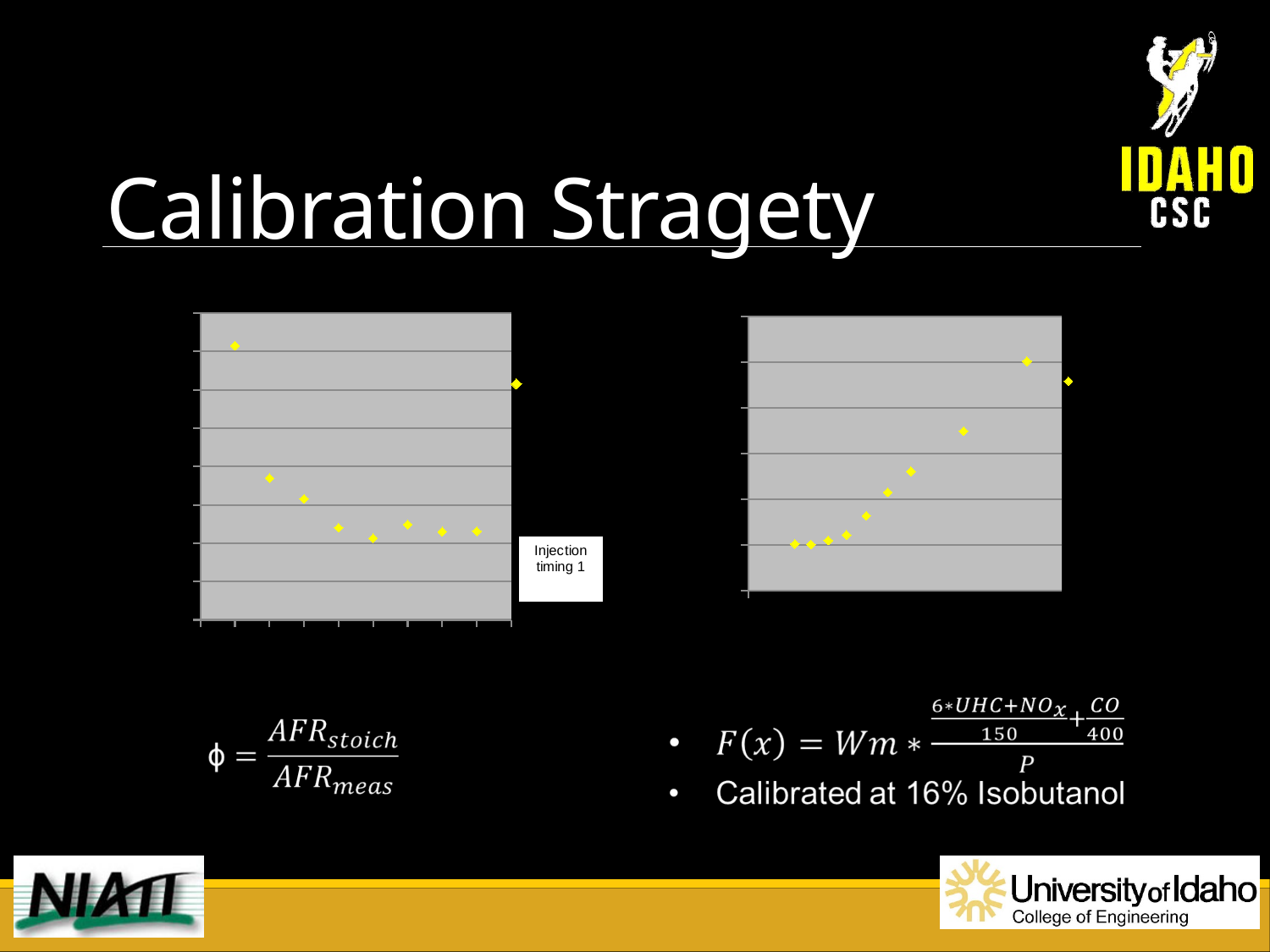
How many data points are plotted in the left chart? 8 What kind of chart is the chart on the right of the slide? scatter chart What is the legend entry shown next to the left chart? Injection timing 1 How many data points are plotted in the right chart? 9 What colour are the data point markers in the two charts? yellow How many series does the legend of the left chart list? 1 In the right chart, do the plotted values generally rise or fall from left to right along the x axis? rise What kind of chart is the chart on the left of the slide? scatter chart